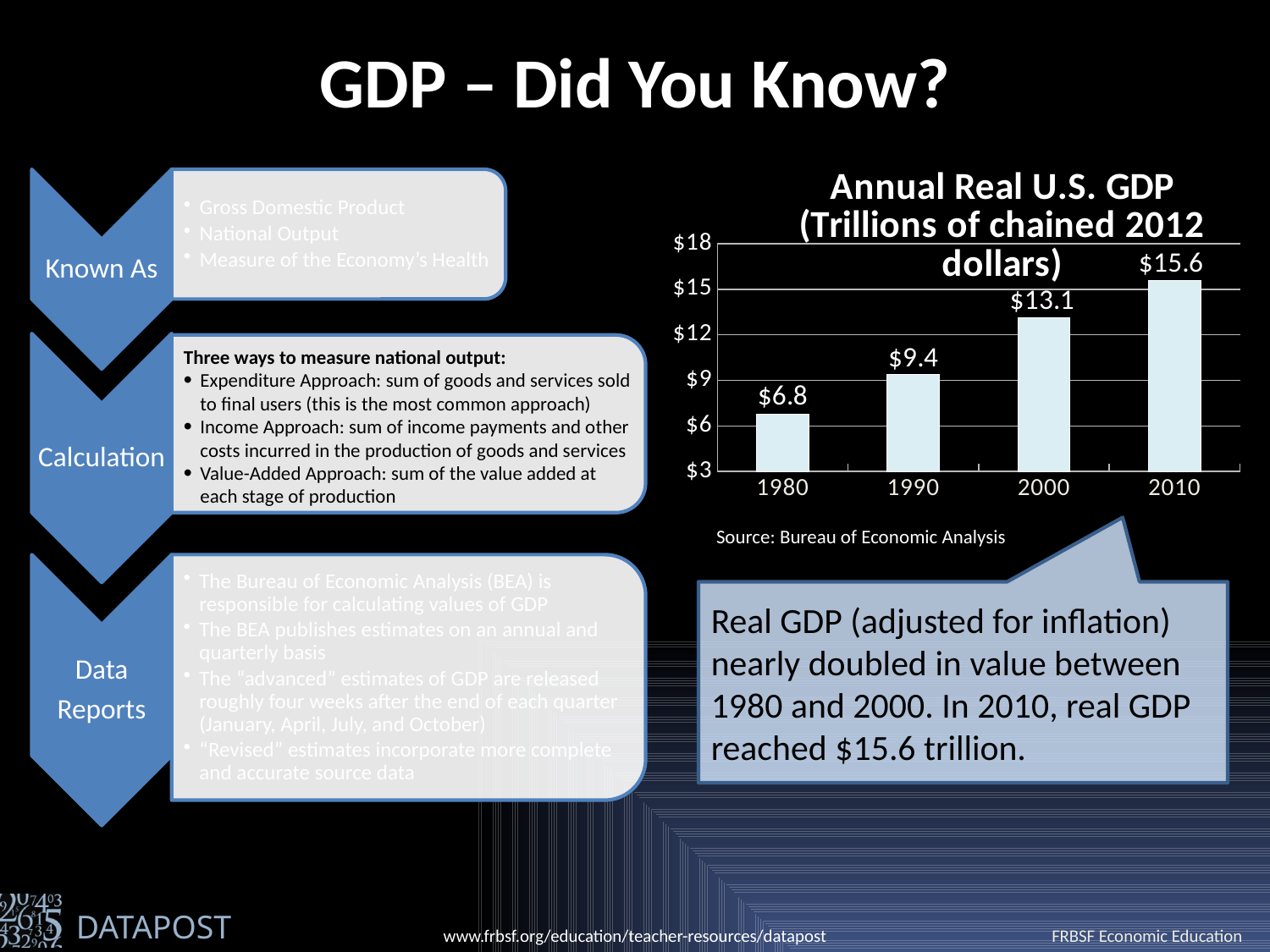
What is the difference between the 2010 and 1980 values in the chart? $8.8 What is the value for 2000 in the Annual Real U.S. GDP chart? $13.1 Which year has the lowest real GDP in the chart? 1980 What is the value for 1980 in the Annual Real U.S. GDP chart? $6.8 What is the value for 2010 in the Annual Real U.S. GDP chart? $15.6 Which year has the highest real GDP in the chart? 2010 Is the value for 2000 greater or less than $12? greater How many years are shown in the Annual Real U.S. GDP chart? 4 What kind of chart is used to show Annual Real U.S. GDP? bar chart What is the value for 1990 in the Annual Real U.S. GDP chart? $9.4 Which is larger in the chart, the value for 1990 or the value for 2000? 2000 Do the values in the chart rise or fall from 1980 to 2010? rise